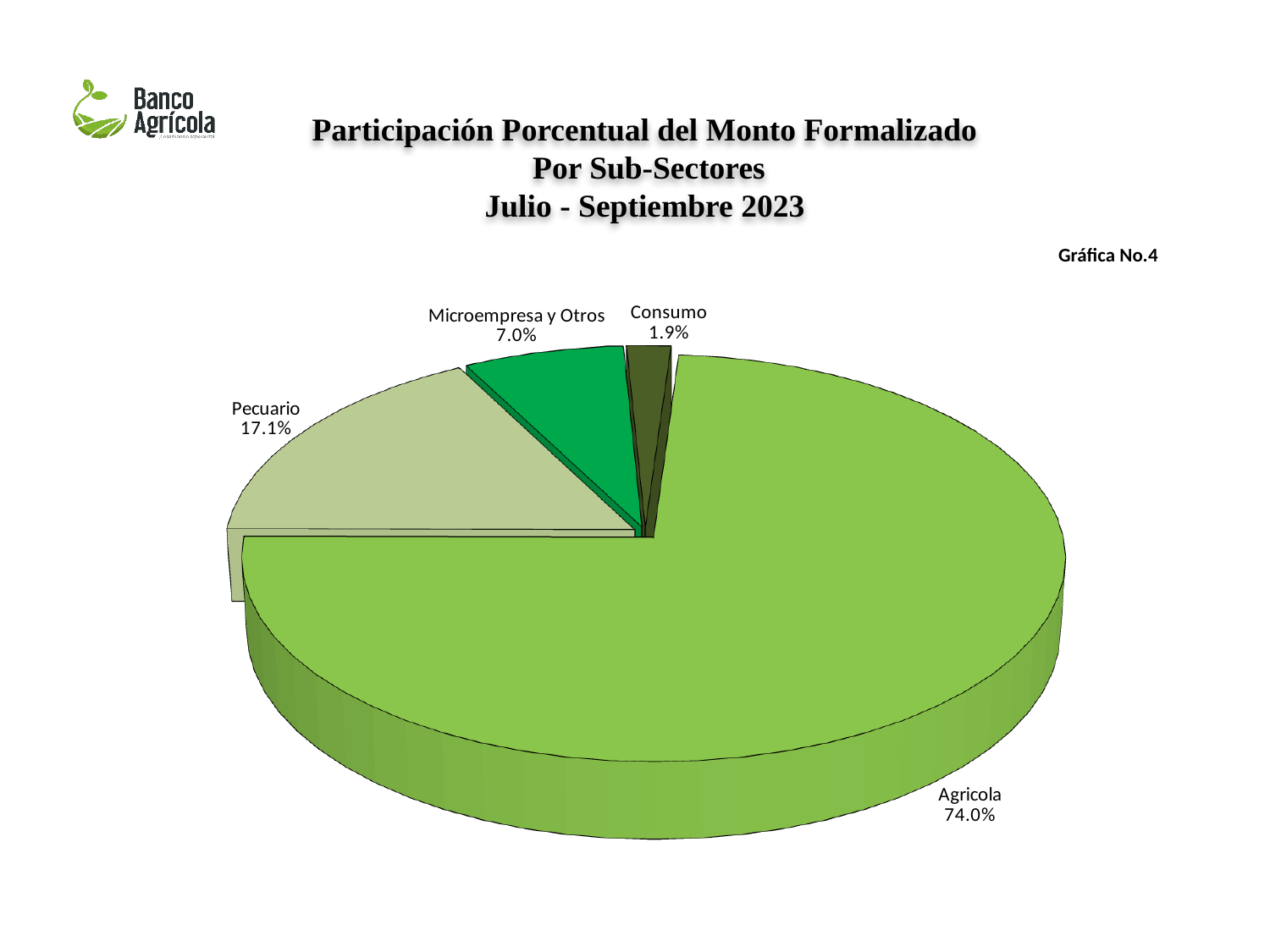
What is the difference in percentage points between Microempresa y Otros and Consumo? 5.1 Which sub-sector has the smallest share of the pie? Consumo Which sub-sector has the largest share of the pie? Agricola What percentage is shown for Consumo? 1.9% What type of chart is shown on the slide? Pie chart What share of the pie does Agricola represent? 74.0% What is the difference in percentage points between Agricola and Pecuario? 56.9 What percentage is shown for Pecuario? 17.1% Which has a larger share, Pecuario or Microempresa y Otros? Pecuario How many sub-sectors are shown in the pie chart? 4 What is the period covered by the chart according to its title? Julio - Septiembre 2023 What percentage is shown for Microempresa y Otros? 7.0%